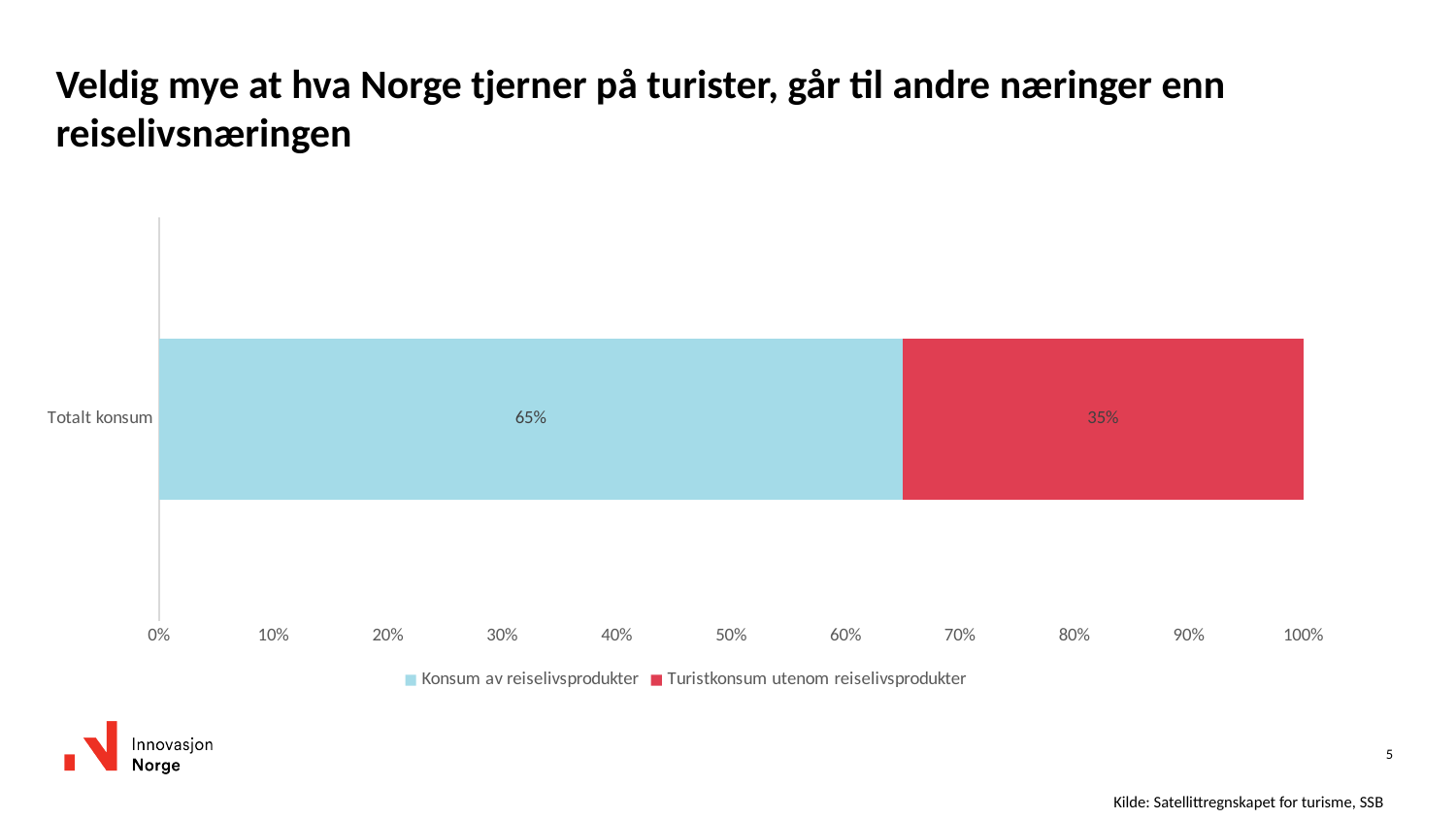
Which colour represents Turistkonsum utenom reiselivsprodukter? Red What is the value for Turistkonsum utenom reiselivsprodukter in the Totalt konsum bar? 35% Which series has the larger share of Totalt konsum? Konsum av reiselivsprodukter What kind of chart is shown on the slide? Stacked bar chart What is the total of the stacked Totalt konsum bar? 100% Is the value for Konsum av reiselivsprodukter larger or smaller than the value for Turistkonsum utenom reiselivsprodukter? larger How many categories are shown on the y axis? 1 What is the value for Konsum av reiselivsprodukter in the Totalt konsum bar? 65% Is the value for Turistkonsum utenom reiselivsprodukter greater or less than 50%? less What is the difference between Konsum av reiselivsprodukter and Turistkonsum utenom reiselivsprodukter? 30% Which series has the smaller share of Totalt konsum? Turistkonsum utenom reiselivsprodukter How many series does the legend list? 2